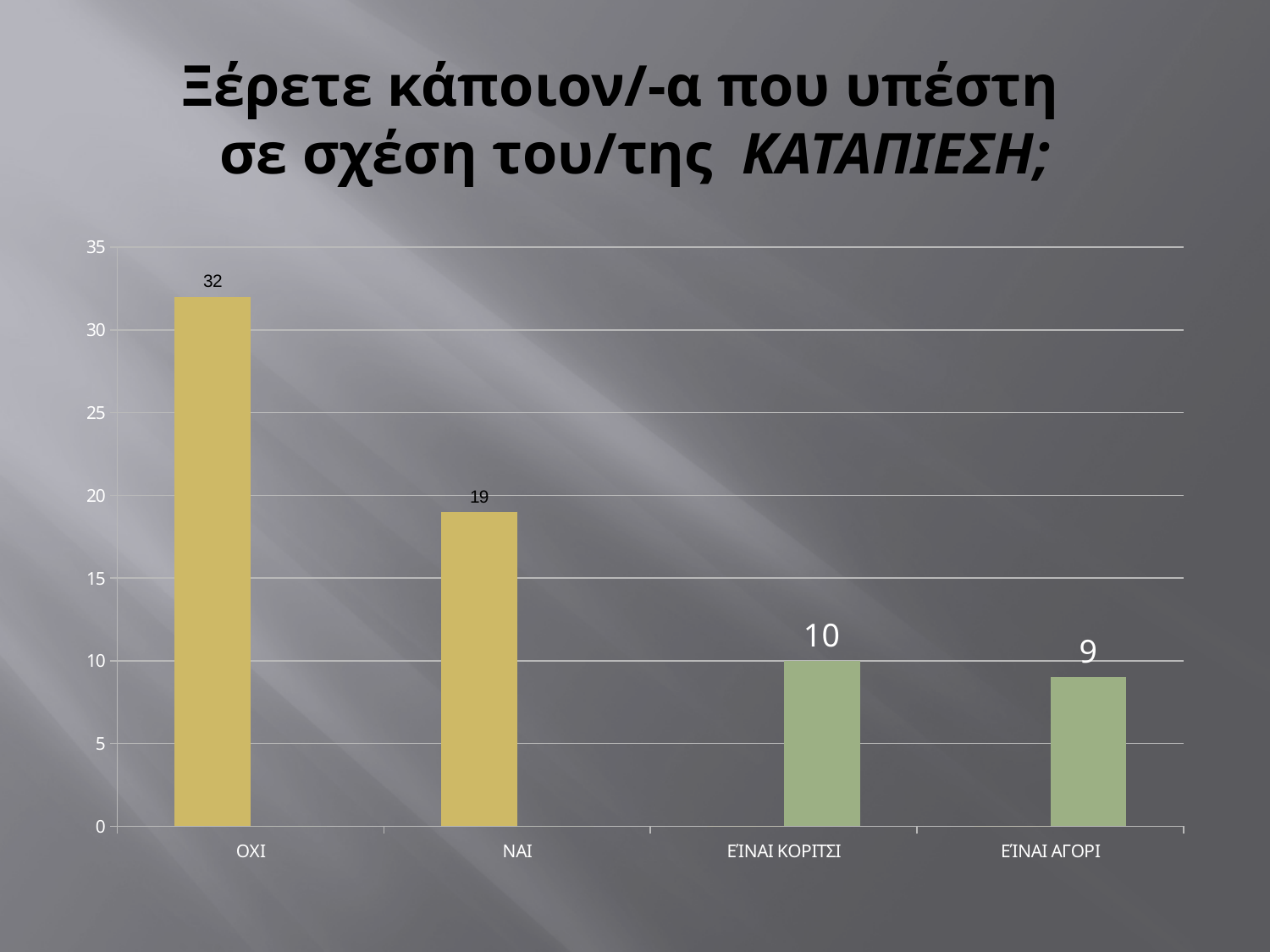
What is the value for ΕΊΝΑΙ ΚΟΡΙΤΣΙ? 10 Which is larger, the value for ΝΑΙ or the value for ΕΊΝΑΙ ΚΟΡΙΤΣΙ? ΝΑΙ Is the value for ΝΑΙ greater or less than 20? less What is the value for ΟΧΙ? 32 What is the value for ΝΑΙ? 19 Which category has the lowest value? ΕΊΝΑΙ ΑΓΟΡΙ What is the difference between the values for ΟΧΙ and ΝΑΙ? 13 What is the value for ΕΊΝΑΙ ΑΓΟΡΙ? 9 What kind of chart is shown on the slide? bar chart How many categories are shown on the x axis? 4 What is the highest value shown on the vertical axis? 35 Which category has the highest value? ΟΧΙ